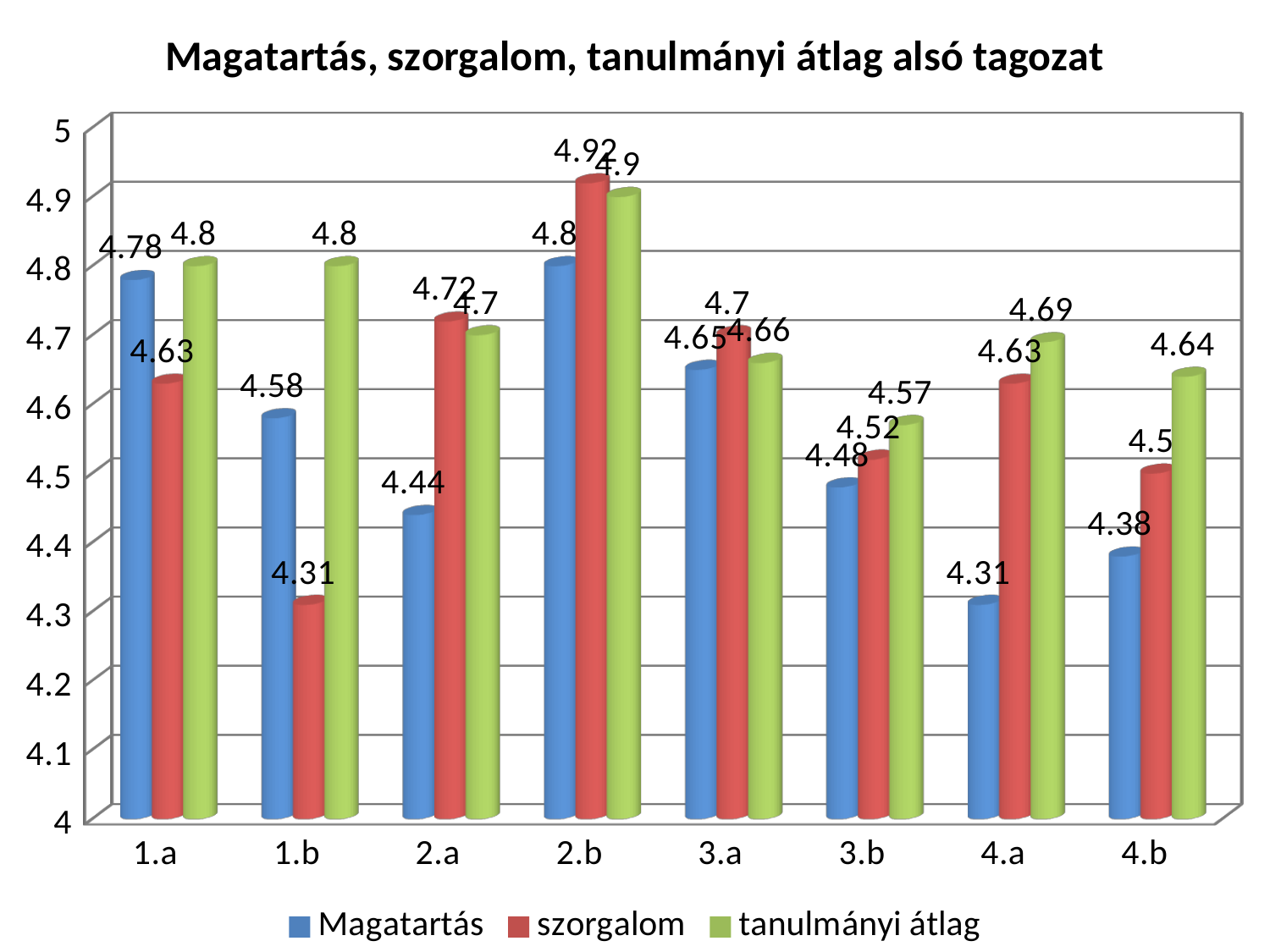
How many categories are shown on the x axis? 8 What is the szorgalom value for 2.b? 4.92 What is the tanulmányi átlag value for 4.b? 4.64 What kind of chart is shown on the slide? bar chart Which category has the lowest Magatartás value? 4.a Which has the larger Magatartás value, 1.a or 1.b? 1.a Which category has the highest szorgalom value? 2.b What is the Magatartás value for 1.a? 4.78 How many series does the legend list? 3 What is the szorgalom value for 1.b? 4.31 Is the Magatartás value for 4.a greater or less than 4.4? less What is the difference between the szorgalom values for 2.b and 1.b? 0.61